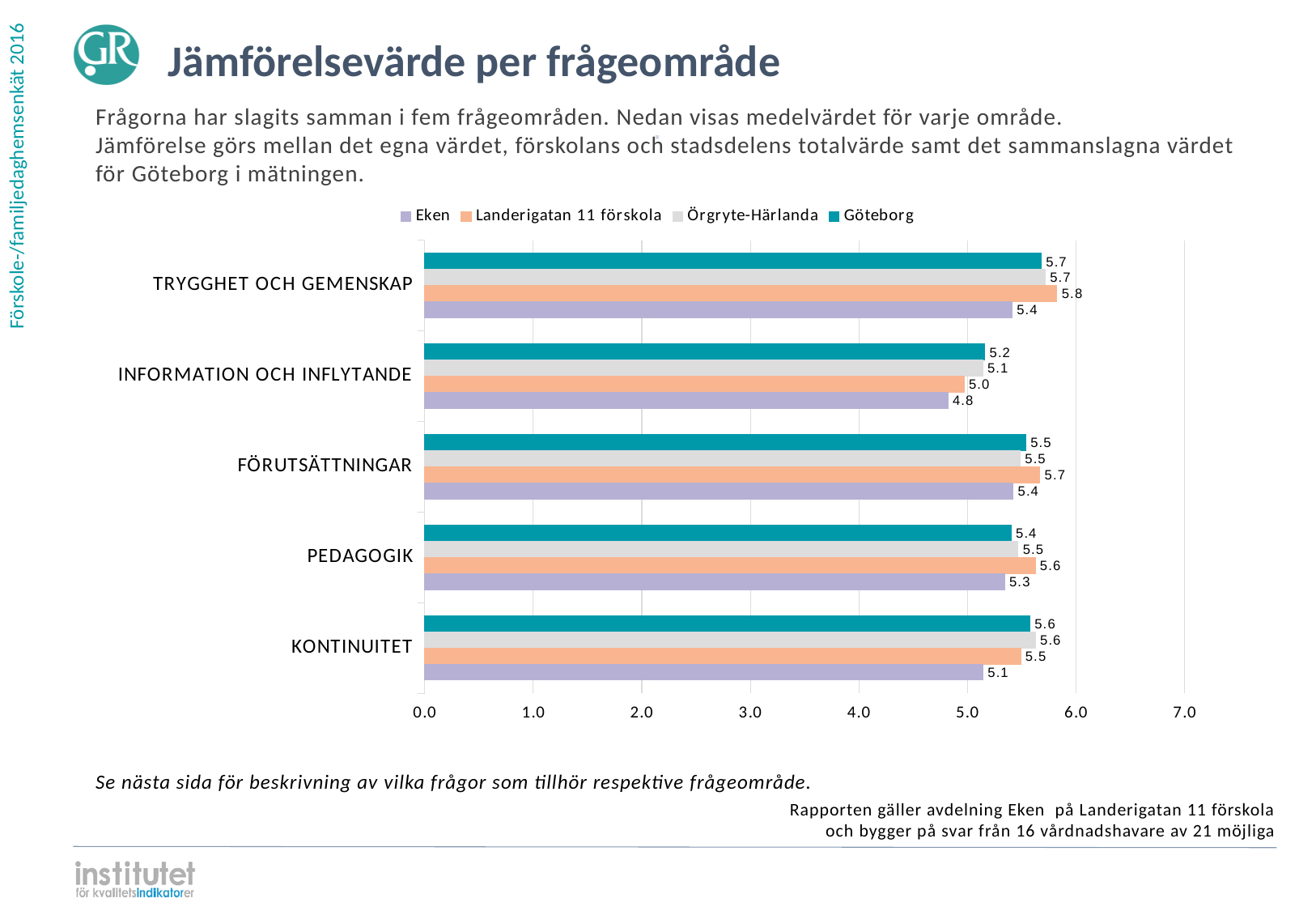
What kind of chart is shown on the slide? bar chart In which category does Eken have its lowest value? INFORMATION OCH INFLYTANDE What is the value for Landerigatan 11 förskola in the TRYGGHET OCH GEMENSKAP category? 5.8 Which is larger in the KONTINUITET category: the value for Göteborg or the value for Eken? Göteborg What is the value for Örgryte-Härlanda in the PEDAGOGIK category? 5.5 How many categories are shown on the chart? 5 What is the value for Eken in the INFORMATION OCH INFLYTANDE category? 4.8 Is the value for Eken in the INFORMATION OCH INFLYTANDE category greater or less than 5.0? less What is the value for Göteborg in the KONTINUITET category? 5.6 What is the difference between the Landerigatan 11 förskola value and the Eken value in the FÖRUTSÄTTNINGAR category? 0.3 In which category does Landerigatan 11 förskola have its highest value? TRYGGHET OCH GEMENSKAP How many series does the legend list? 4